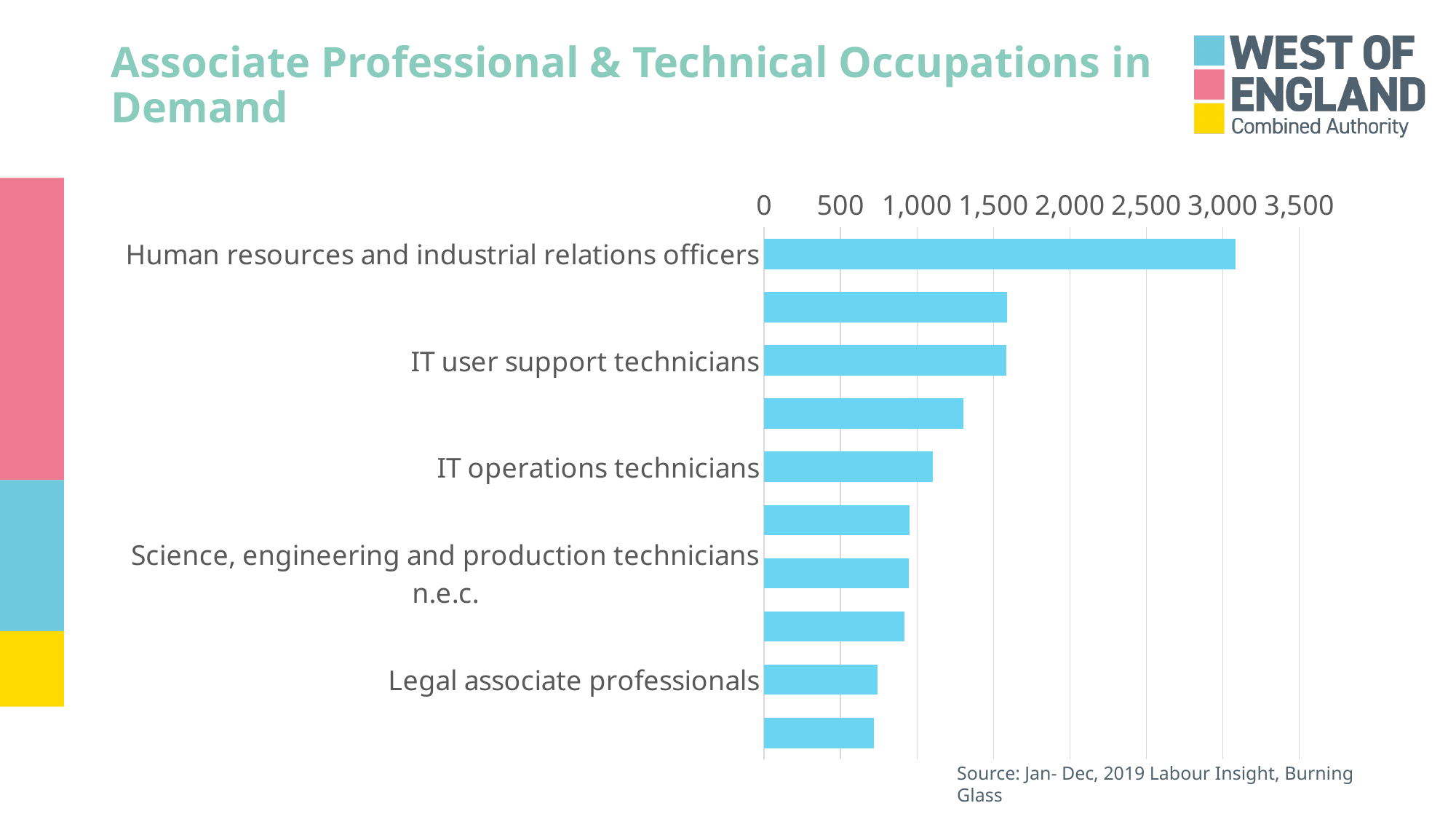
Is the value for Human resources and industrial relations officers greater or less than 2,500? greater Is the value for IT user support technicians greater or less than 1,500? greater Which occupation has the highest value in the chart? Human resources and industrial relations officers What type of chart is shown on the slide? Bar chart Do the bar values increase or decrease from the top of the chart to the bottom? Decrease Of the labelled occupations, which has the shortest bar? Legal associate professionals Is the value for IT operations technicians greater or less than 1,500? less How many bars are plotted in the chart? 10 Which has the larger value: IT user support technicians or IT operations technicians? IT user support technicians What is the title of the slide? Associate Professional & Technical Occupations in Demand